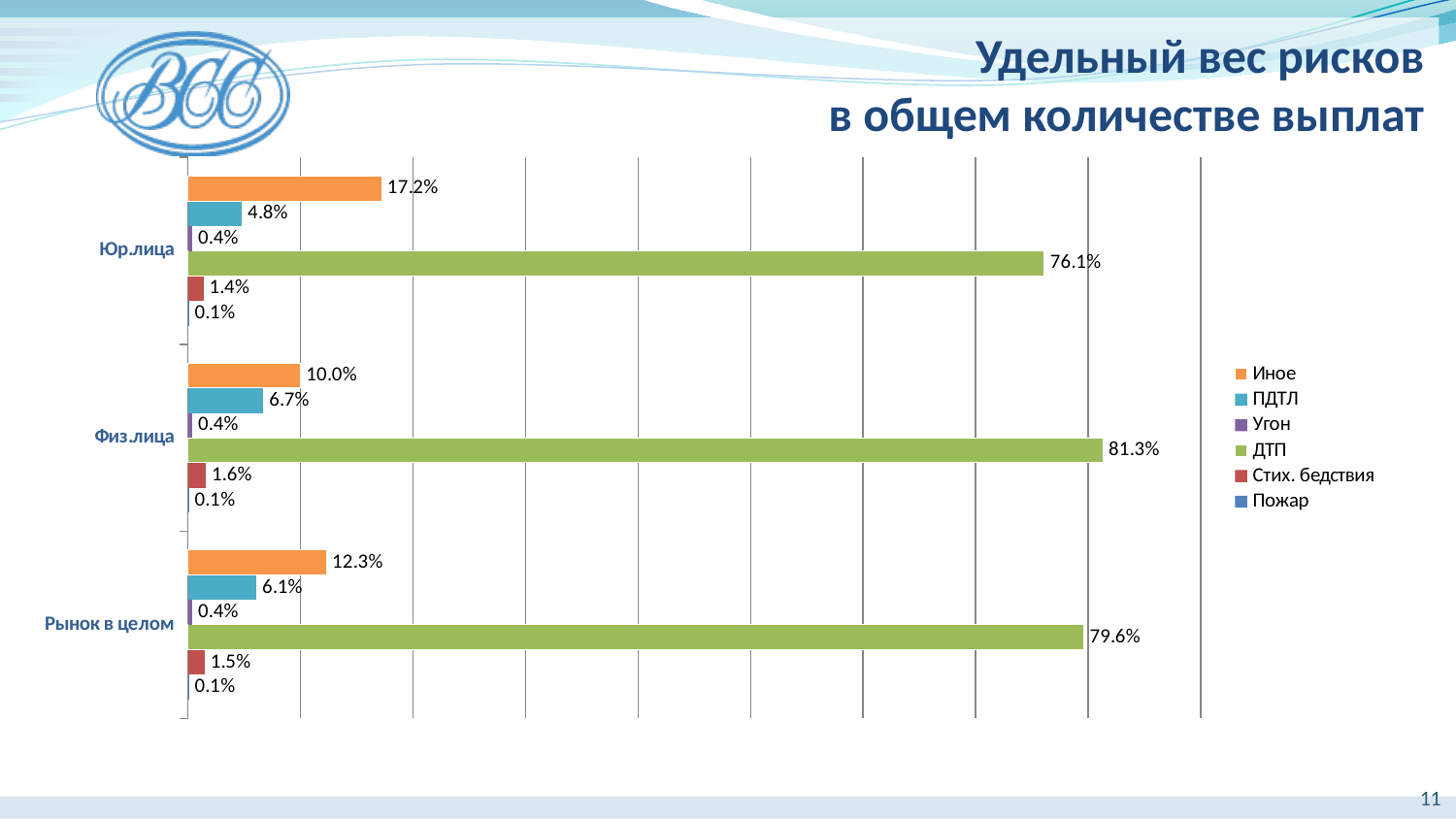
What is the value of ДТП for Юр.лица? 76.1% Which category has the highest value for ДТП? Физ.лица What is the value of Стих. бедствия for Физ.лица? 1.6% Which category has the lowest value for Иное? Физ.лица How many categories are shown on the vertical axis? 3 What type of chart is shown on the slide? Bar chart How many series does the legend list? 6 What is the value of Иное for Физ.лица? 10.0% Which is larger: ПДТЛ for Юр.лица or ПДТЛ for Физ.лица? ПДТЛ for Физ.лица What is the value of ПДТЛ for Рынок в целом? 6.1% What is the title of the slide? Удельный вес рисков в общем количестве выплат What is the difference between the Иное values for Юр.лица and Физ.лица? 7.2%